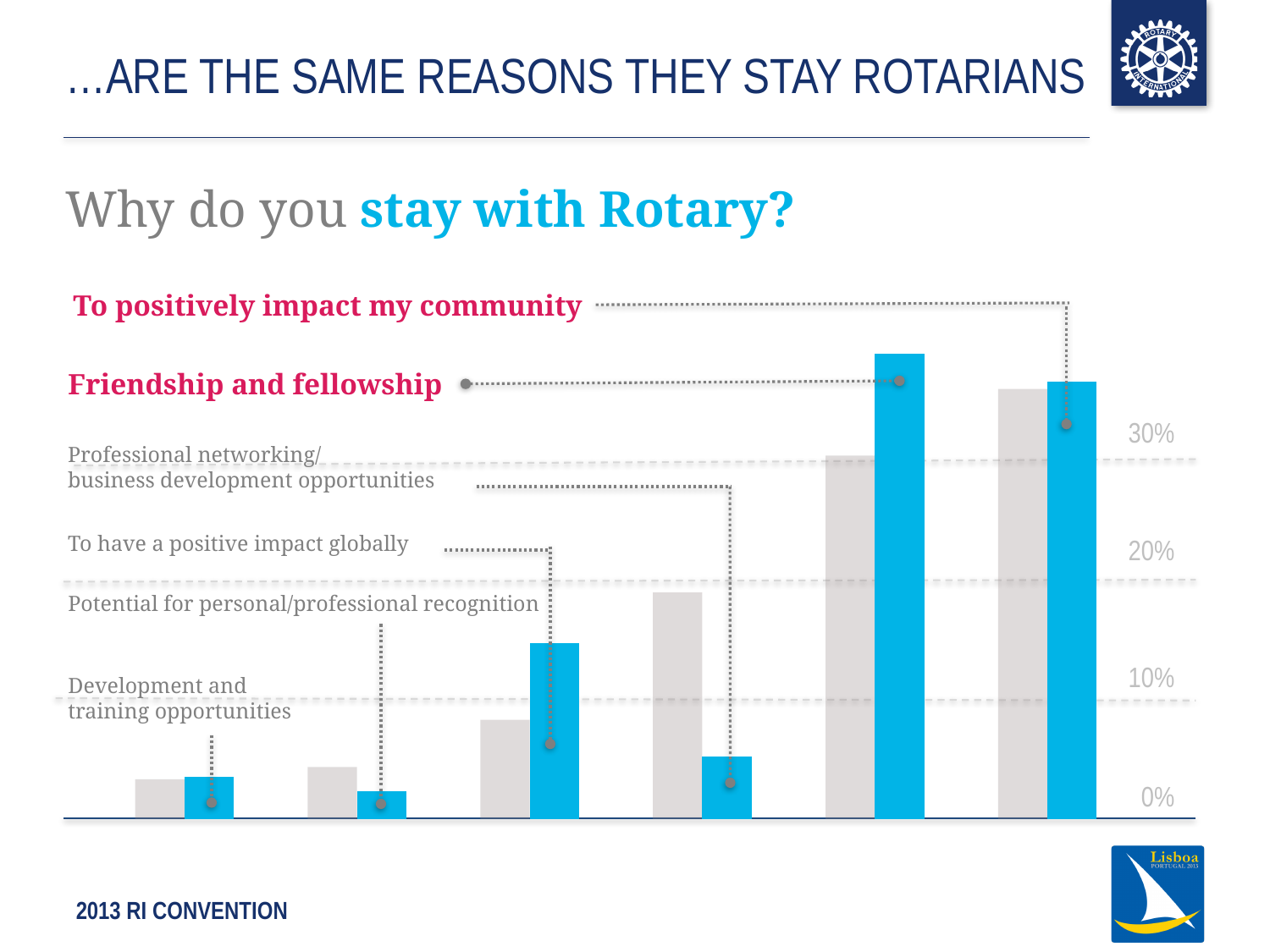
Which category has the tallest blue bar? Friendship and fellowship Is the blue bar for Friendship and fellowship greater or less than 30%? greater What is the title of the chart? Why do you stay with Rotary? Is the blue bar for To have a positive impact globally greater or less than 20%? less For Friendship and fellowship, which bar is taller, the grey bar or the blue bar? blue bar For Professional networking/business development opportunities, which bar is taller, the grey bar or the blue bar? grey bar Is the blue bar for Professional networking/business development opportunities greater or less than 10%? less What kind of chart is shown on the slide? bar chart Which category has the tallest grey bar? To positively impact my community How many categories (reasons) are plotted in the chart? 6